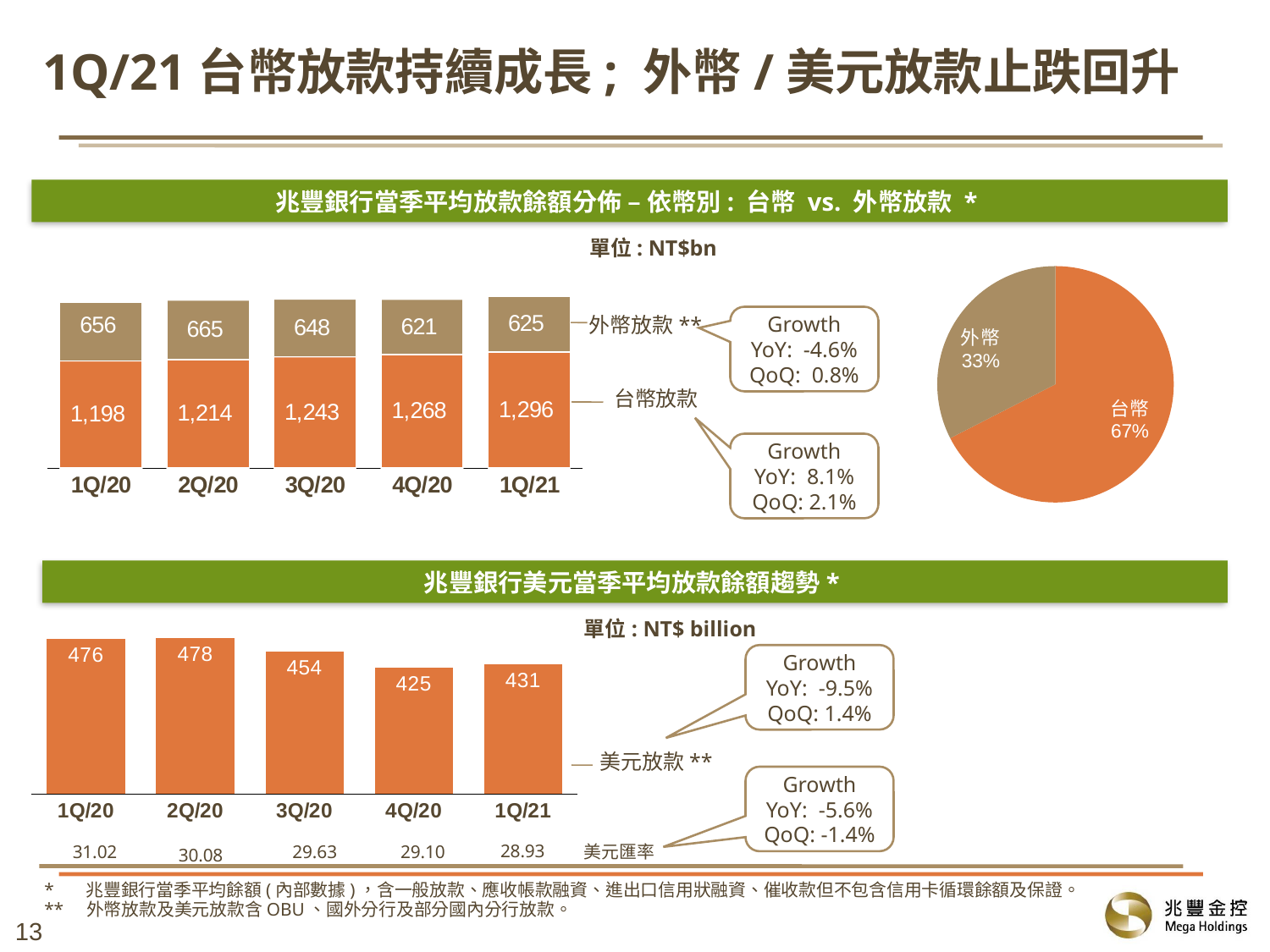
In the top stacked bar chart (台幣 vs. 外幣放款), what is the value of 外幣放款 for 2Q/20? 665 In the top stacked bar chart (台幣 vs. 外幣放款), do the 台幣放款 values rise or fall from 1Q/20 to 1Q/21? rise In the top stacked bar chart (台幣 vs. 外幣放款), what is the value of 台幣放款 for 1Q/21? 1,296 In the bottom bar chart (美元當季平均放款餘額趨勢), what is the difference between the 1Q/20 and 1Q/21 values? 45 In the top stacked bar chart (台幣 vs. 外幣放款), what is the total of the 1Q/21 bar? 1,921 Below the bottom bar chart, what is the 美元匯率 shown for 1Q/21? 28.93 How many quarters are shown on the x axis of the top stacked bar chart (台幣 vs. 外幣放款)? 5 In the bottom bar chart (美元當季平均放款餘額趨勢), what is the 美元放款 value for 4Q/20? 425 In the pie chart at the top right, what share does 外幣 have? 33% In the top stacked bar chart (台幣 vs. 外幣放款), which quarter has the highest 外幣放款 value? 2Q/20 In the bottom bar chart (美元當季平均放款餘額趨勢), which quarter has the lowest 美元放款 value? 4Q/20 What kind of chart is the bottom chart (美元當季平均放款餘額趨勢)? bar chart